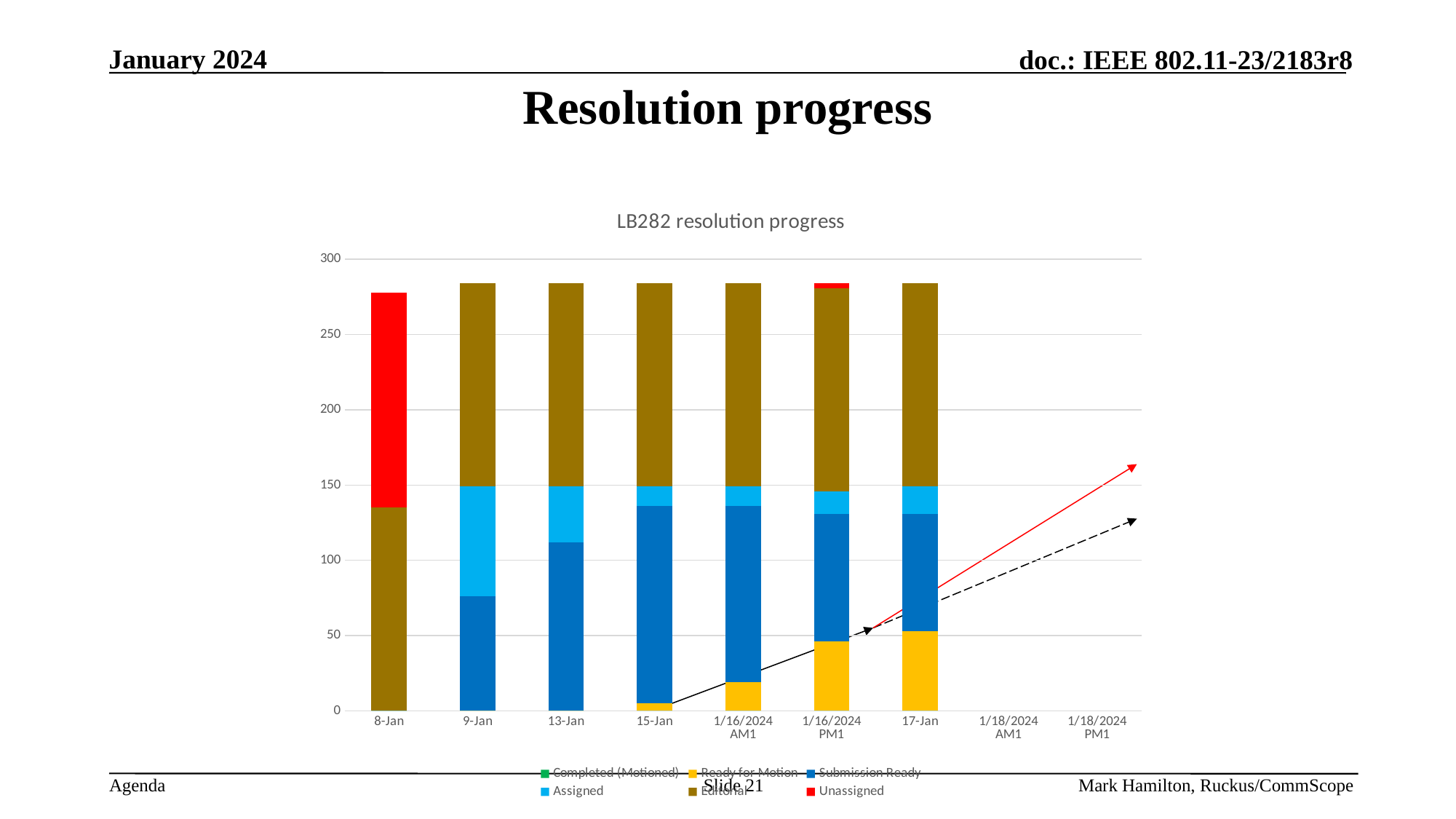
Is the Unassigned segment on 8-Jan greater or less than 100? greater How many dates have a stacked bar plotted? 7 How many date categories are labelled on the x axis? 9 How many series does the chart legend list? 6 Is the total bar height for 9-Jan greater or less than 300? less Which colour represents the Unassigned series in the legend? red Which date has the shortest total stacked bar among those plotted? 8-Jan Is the total bar height for 8-Jan greater or less than 250? greater Which date has the largest Unassigned (red) segment? 8-Jan What kind of chart is shown on the slide? stacked bar chart Does the Ready for Motion segment rise or fall from 15-Jan to 17-Jan? rise What is the title of the chart? LB282 resolution progress